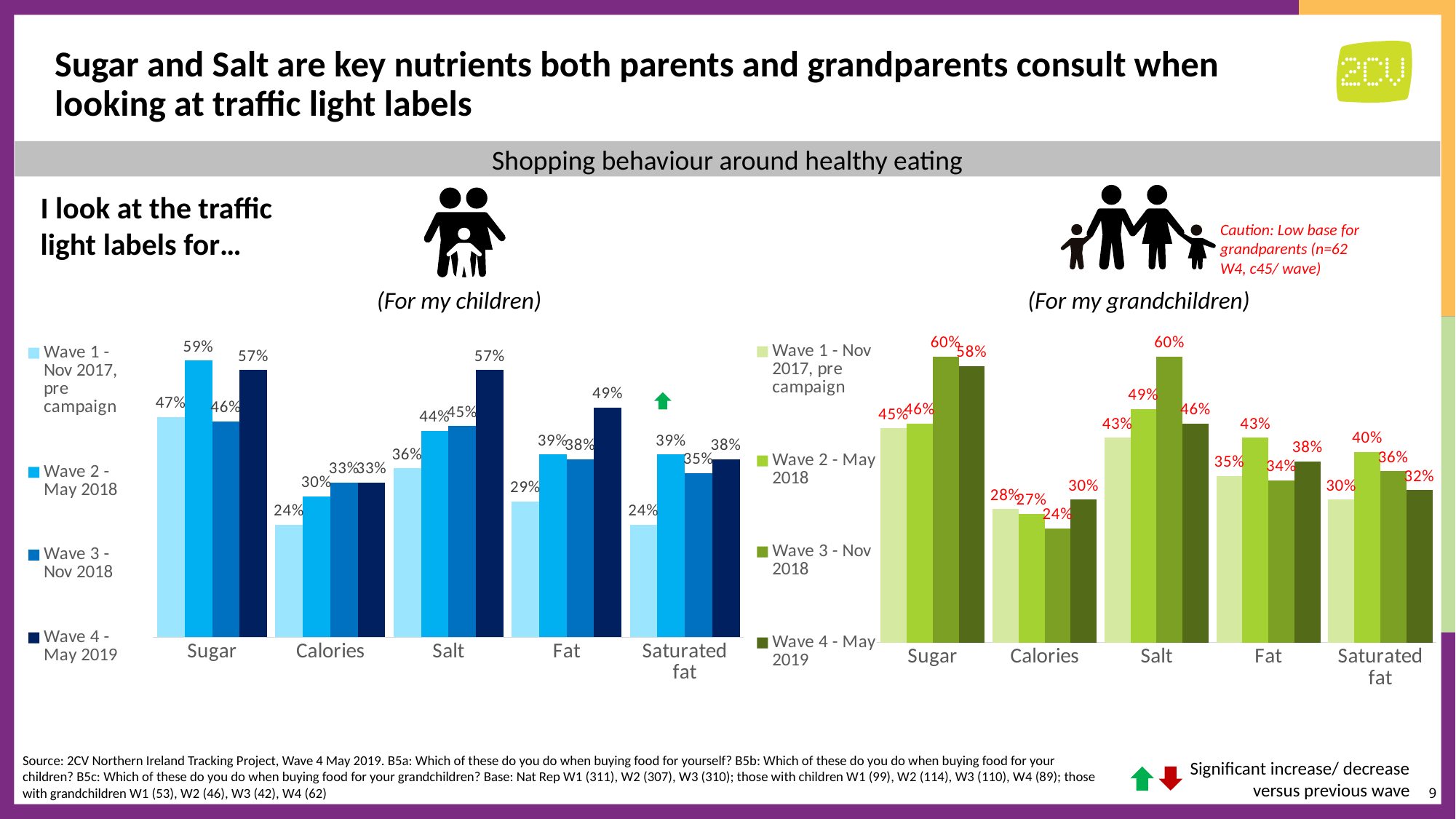
In the 'For my children' chart, do the values for Salt rise or fall from Wave 1 to Wave 4? Rise In the 'For my grandchildren' chart, which is larger for Salt: the Wave 3 - Nov 2018 value or the Wave 4 - May 2019 value? Wave 3 - Nov 2018 In the 'For my children' chart, what is the Wave 4 - May 2019 value for Salt? 57% What type of chart is the 'For my children' chart? Bar chart In the 'For my grandchildren' chart, which category has the highest Wave 4 - May 2019 value? Sugar In the 'For my children' chart, what is the difference between the Wave 4 - May 2019 and Wave 1 - Nov 2017 values for Fat? 20% In the 'For my children' chart, what is the Wave 1 - Nov 2017 value for Calories? 24% In the 'For my grandchildren' chart, what is the Wave 2 - May 2018 value for Saturated fat? 40% How many categories are shown on the x axis of the 'For my children' chart? 5 In the 'For my grandchildren' chart, what is the Wave 3 - Nov 2018 value for Sugar? 60% In the 'For my children' chart, which category has the lowest Wave 4 - May 2019 value? Calories How many series does the legend of the 'For my grandchildren' chart list? 4